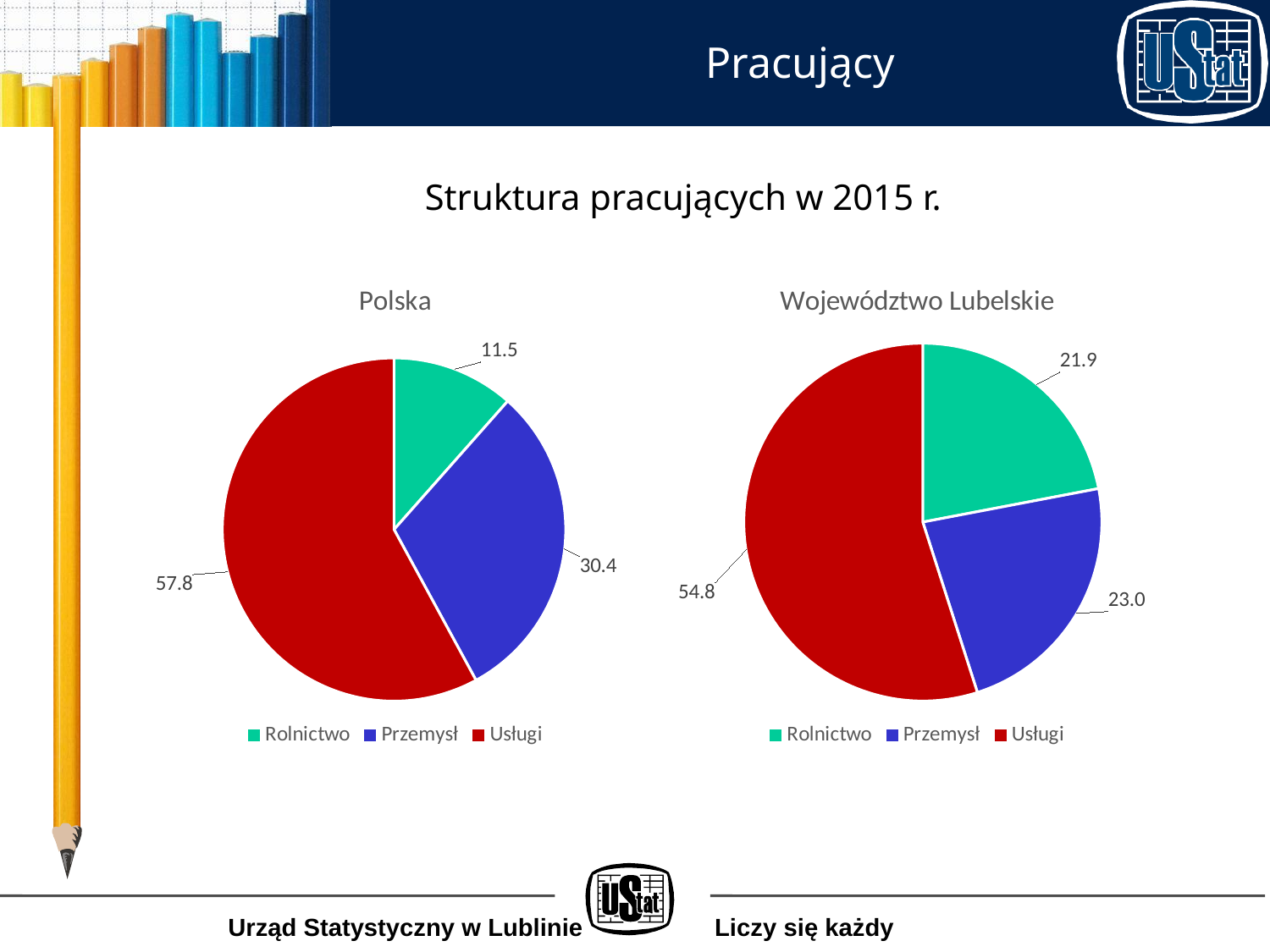
In the 'Województwo Lubelskie' pie chart, which category has the smallest slice? Rolnictwo What type of chart is used for 'Województwo Lubelskie'? Pie chart In the 'Polska' pie chart, which category has the largest slice? Usługi Which is larger: the Rolnictwo value in the 'Polska' chart or the Rolnictwo value in the 'Województwo Lubelskie' chart? Województwo Lubelskie In the 'Województwo Lubelskie' pie chart, what is the value for Usługi? 54.8 In the 'Województwo Lubelskie' pie chart, what is the difference between the Przemysł and Rolnictwo values? 1.1 In the 'Polska' pie chart, what colour is the Usługi slice? Red In the 'Polska' pie chart, what is the value for Przemysł? 30.4 In the 'Województwo Lubelskie' pie chart, what is the value for Rolnictwo? 21.9 In the 'Polska' pie chart, what is the difference between the Usługi and Przemysł values? 27.4 In the 'Polska' pie chart, what is the value for Rolnictwo? 11.5 How many slices does the 'Polska' pie chart have? 3